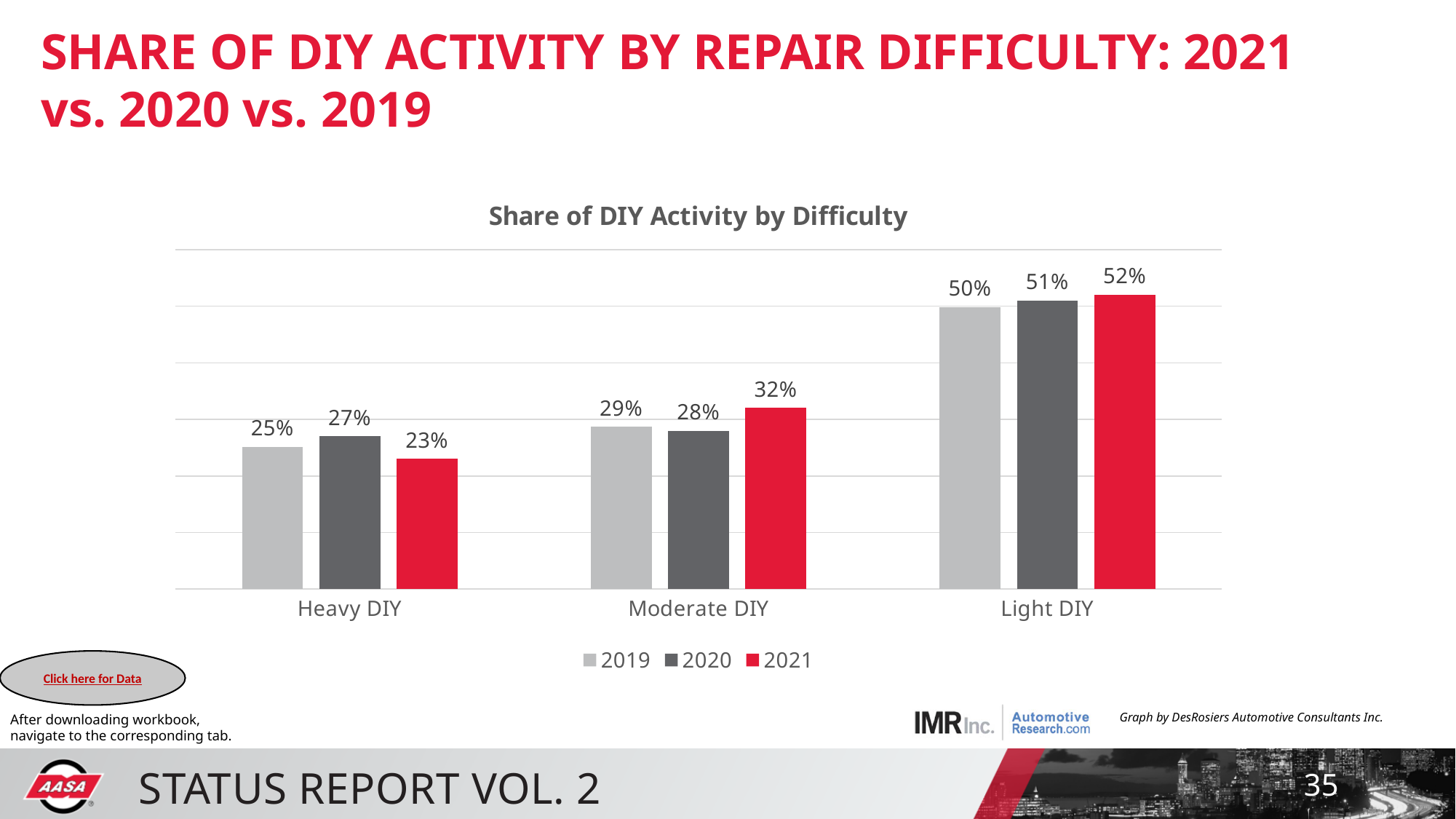
What is the 2020 value for Light DIY? 51% Which colour represents the 2021 series in the legend? Red What is the difference between the 2021 and 2019 values for Moderate DIY? 3% What is the 2019 value for Moderate DIY? 29% How many categories are shown on the x axis? 3 Which category has the lowest 2019 value? Heavy DIY What kind of chart is shown on the slide? Bar chart What is the title of the chart? Share of DIY Activity by Difficulty How many series does the legend list? 3 Which category has the highest 2021 value? Light DIY What is the 2021 value for Heavy DIY? 23% Which is larger for Heavy DIY, the 2020 value or the 2021 value? 2020